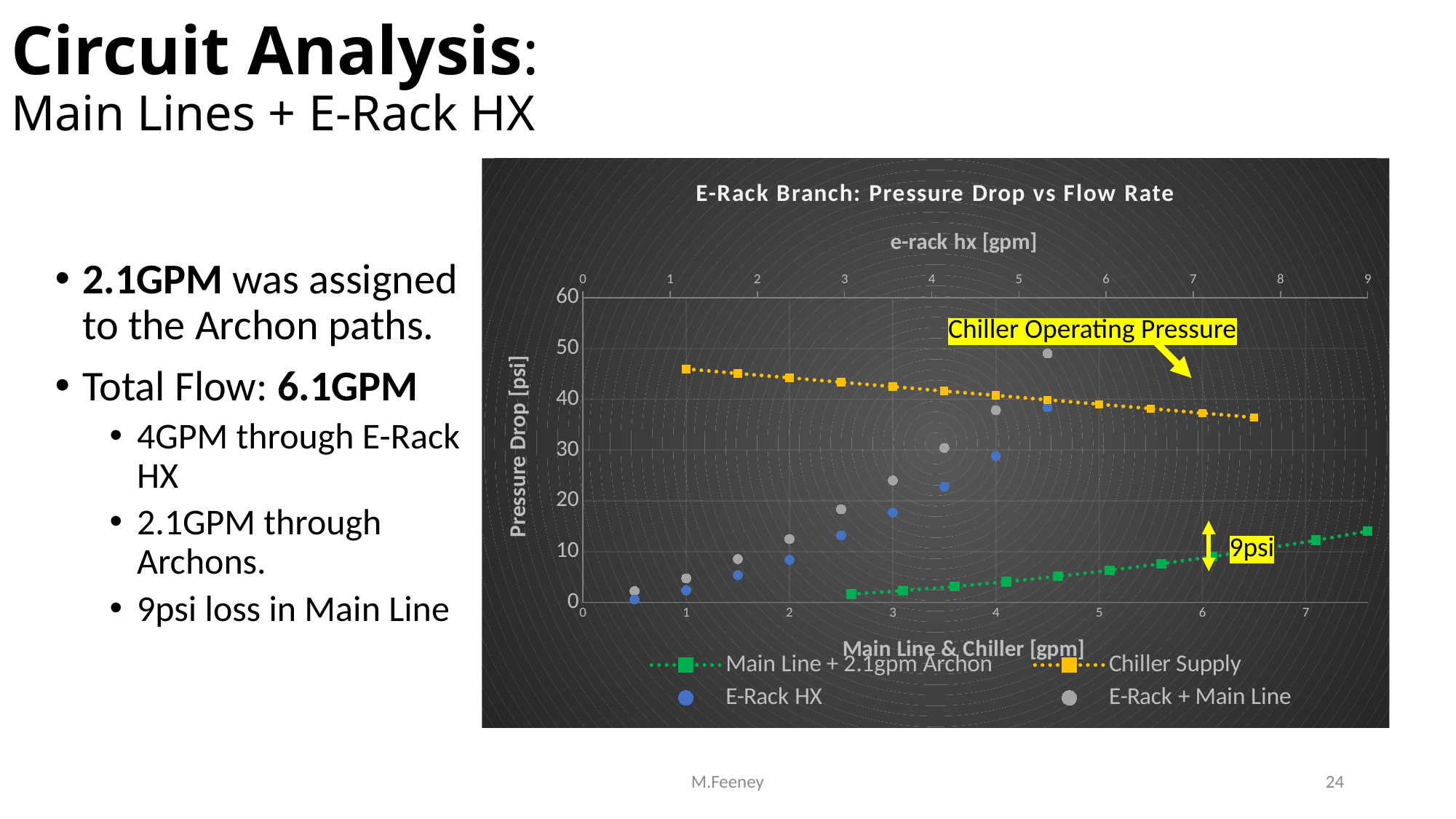
What is the title of the chart? E-Rack Branch: Pressure Drop vs Flow Rate Which is larger at 6 gpm on the Main Line & Chiller axis: the Chiller Supply value or the Main Line + 2.1gpm Archon value? Chiller Supply Does the Main Line + 2.1gpm Archon series rise or fall as flow rate increases along the x axis? rise What is the label of the vertical axis of the chart? Pressure Drop [psi] How many series does the chart legend list? 4 What kind of chart is shown on the slide? scatter chart At 6 gpm on the Main Line & Chiller axis, is the Main Line + 2.1gpm Archon value greater or less than 20? less Does the Chiller Supply series rise or fall as flow rate increases along the x axis? fall Is the highest E-Rack + Main Line point greater or less than 40 psi? greater At 1 gpm on the Main Line & Chiller axis, is the Chiller Supply value greater or less than 40? greater